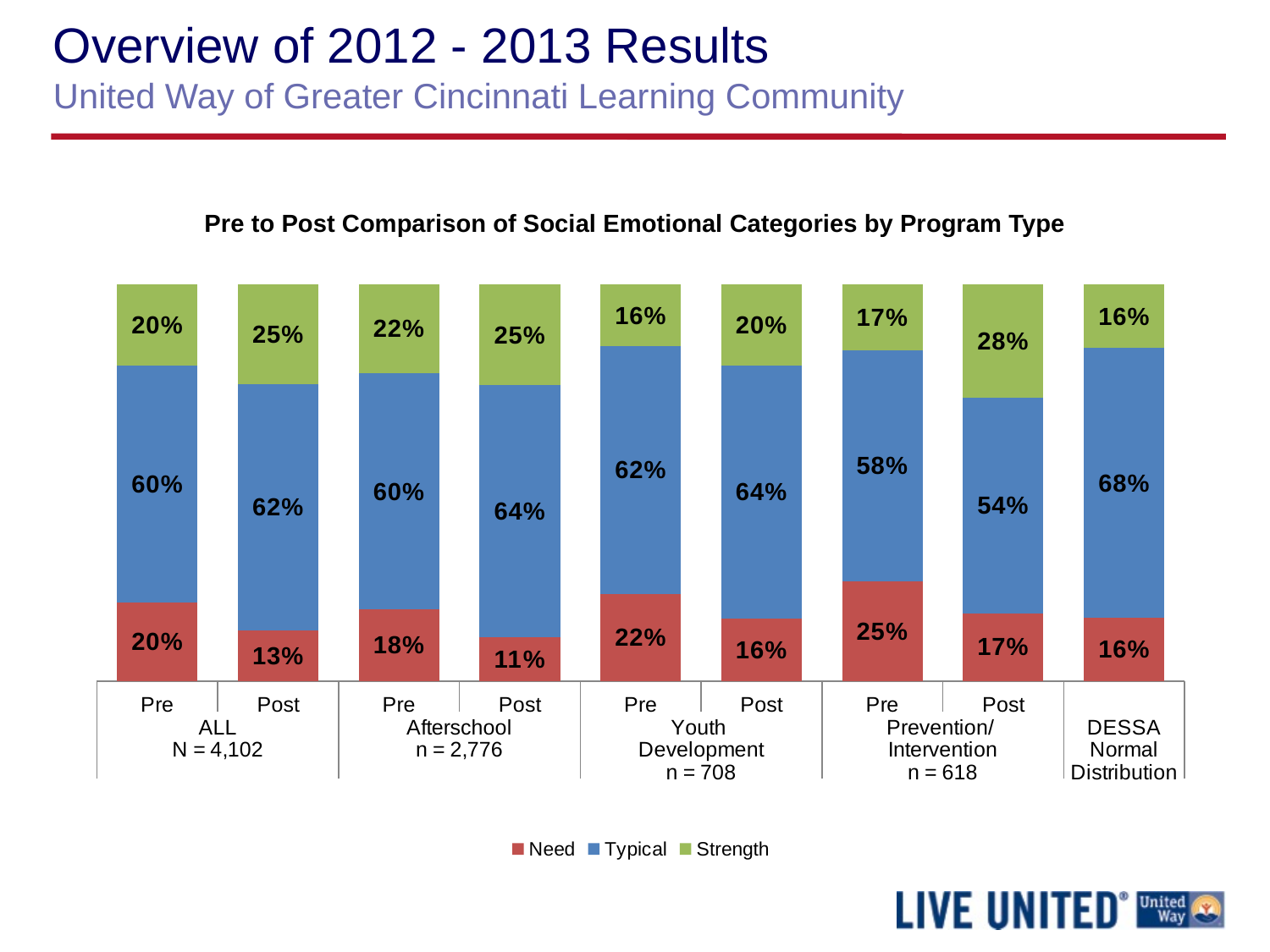
What is the difference between the Need percentage for ALL Pre and ALL Post? 7% How many bars are shown in the chart? 9 Which bar has the lowest Typical percentage? Prevention/Intervention Post What is the Need percentage for the Afterschool Post bar? 11% Which bar has the highest Need percentage? Prevention/Intervention Pre What is the Typical percentage for the DESSA Normal Distribution bar? 68% What is the total of the Afterschool Pre stacked bar? 100% Which is larger, the Strength percentage for Youth Development Pre or Youth Development Post? Youth Development Post How many series does the legend list? 3 What kind of chart is shown on the slide? Stacked bar chart What is the title of the chart? Pre to Post Comparison of Social Emotional Categories by Program Type What is the Strength percentage for the Prevention/Intervention Post bar? 28%